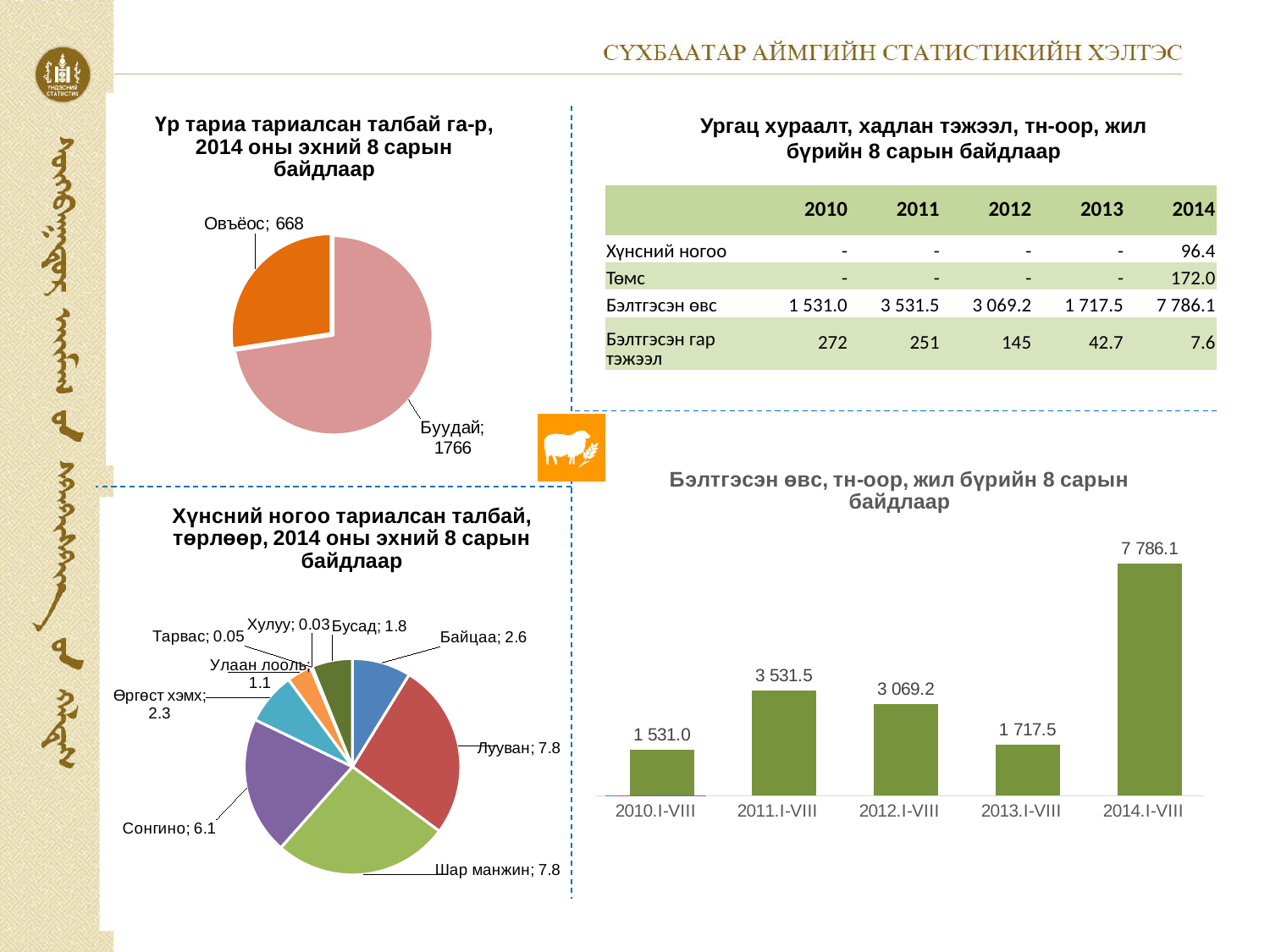
In the bottom-left pie chart (Хүнсний ногоо тариалсан талбай), which is larger, Байцаа or Өргөст хэмх? Байцаа In the top-left pie chart (Үр тариа тариалсан талбай), what is the difference between Буудай and Овъёос? 1098 In the bottom-right chart (Бэлтгэсэн өвс), what is the difference between 2014.I-VIII and 2013.I-VIII? 6 068.6 In the bottom-left pie chart (Хүнсний ногоо тариалсан талбай), which category has the smallest value? Хулуу What type of chart is the bottom-right chart (Бэлтгэсэн өвс)? bar chart In the bottom-left pie chart (Хүнсний ногоо тариалсан талбай), how many categories are shown? 9 In the bottom-right chart (Бэлтгэсэн өвс), which period has the highest value? 2014.I-VIII In the bottom-right chart (Бэлтгэсэн өвс), what is the value for 2012.I-VIII? 3 069.2 In the top-left pie chart (Үр тариа тариалсан талбай), what is the value for Буудай? 1766 In the top-left pie chart (Үр тариа тариалсан талбай), what is the value for Овъёос? 668 In the top-left pie chart (Үр тариа тариалсан талбай), how many slices are there? 2 In the bottom-left pie chart (Хүнсний ногоо тариалсан талбай), what is the value for Сонгино? 6.1